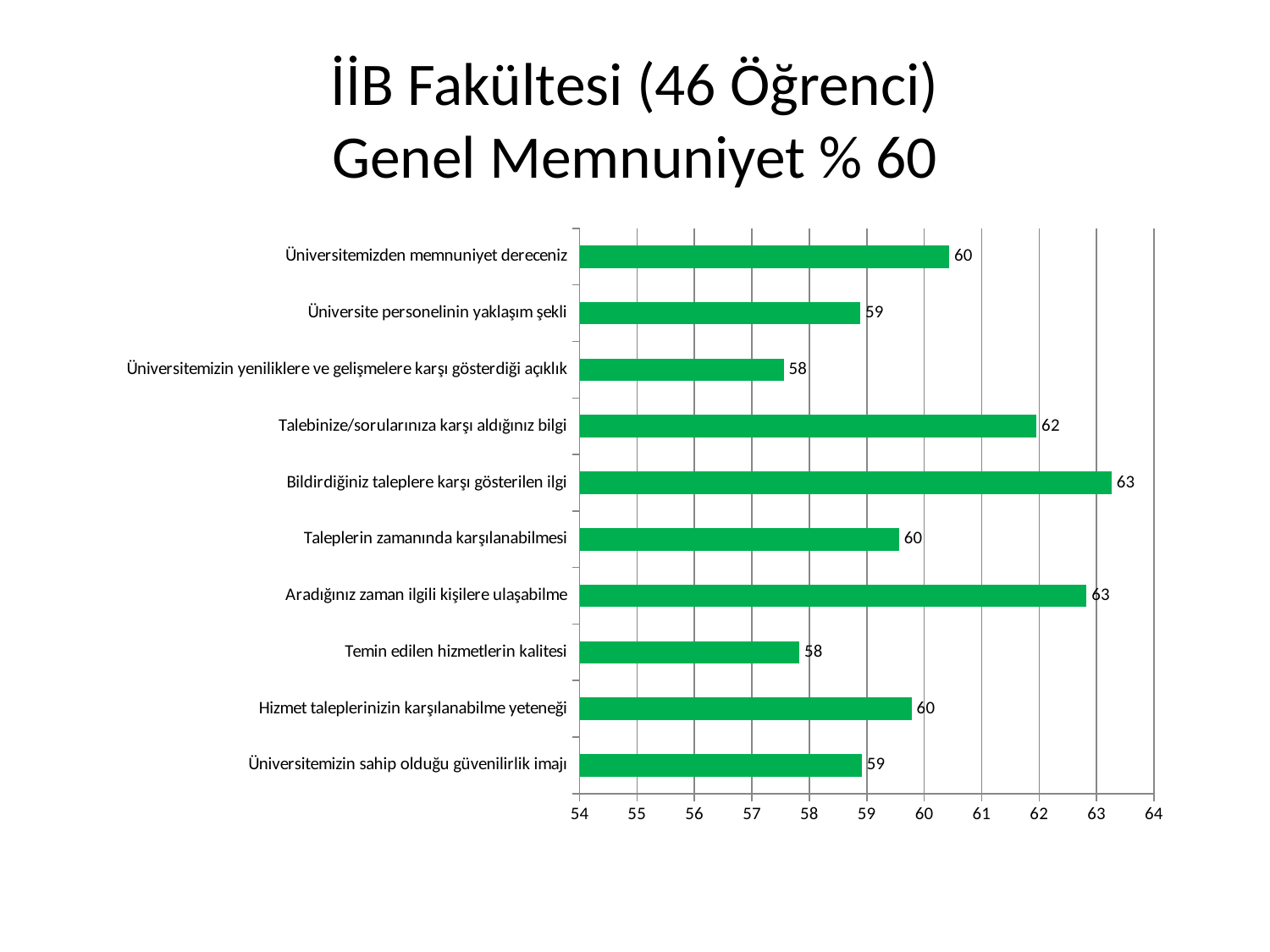
Is the value for "Bildirdiğiniz taleplere karşı gösterilen ilgi" greater or less than 62? greater What is the value for "Üniversitemizin sahip olduğu güvenilirlik imajı"? 59 What is the highest value shown on the chart? 63 What colour are the bars in the chart? green What is the value for "Üniversitemizden memnuniyet dereceniz"? 60 How many categories are shown on the chart? 10 What is the value for "Talebinize/sorularınıza karşı aldığınız bilgi"? 62 Which has a larger value: "Talebinize/sorularınıza karşı aldığınız bilgi" or "Temin edilen hizmetlerin kalitesi"? Talebinize/sorularınıza karşı aldığınız bilgi What is the lowest value shown on the chart? 58 What kind of chart is shown on the slide? bar chart What is the value for "Temin edilen hizmetlerin kalitesi"? 58 What is the difference between the values for "Talebinize/sorularınıza karşı aldığınız bilgi" and "Üniversite personelinin yaklaşım şekli"? 3